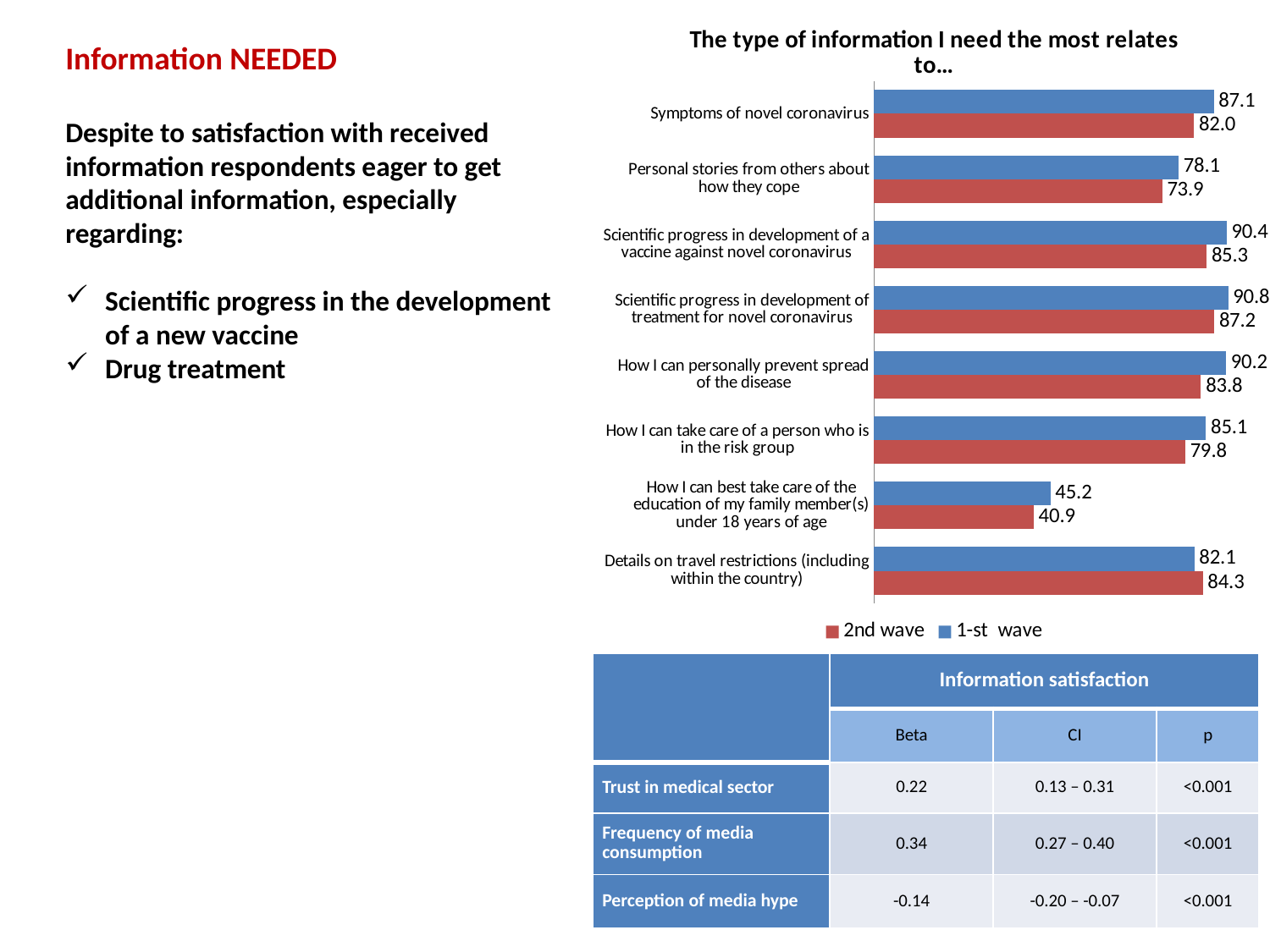
What kind of chart is shown on the slide? Bar chart How many categories are shown in the chart? 8 For "Details on travel restrictions (including within the country)", which series has the larger value, 1-st wave or 2nd wave? 2nd wave Which category has the highest 1-st wave value? Scientific progress in development of treatment for novel coronavirus Which colour represents the 2nd wave series in the chart? Red How many series does the chart legend list? 2 What is the 2nd wave value for "How I can personally prevent spread of the disease"? 83.8 What is the 2nd wave value for "Details on travel restrictions (including within the country)"? 84.3 Which category has the lowest 2nd wave value? How I can best take care of the education of my family member(s) under 18 years of age What is the difference between the 1-st wave and 2nd wave values for "Symptoms of novel coronavirus"? 5.1 What is the title of the chart? The type of information I need the most relates to… What is the 1-st wave value for "Symptoms of novel coronavirus"? 87.1